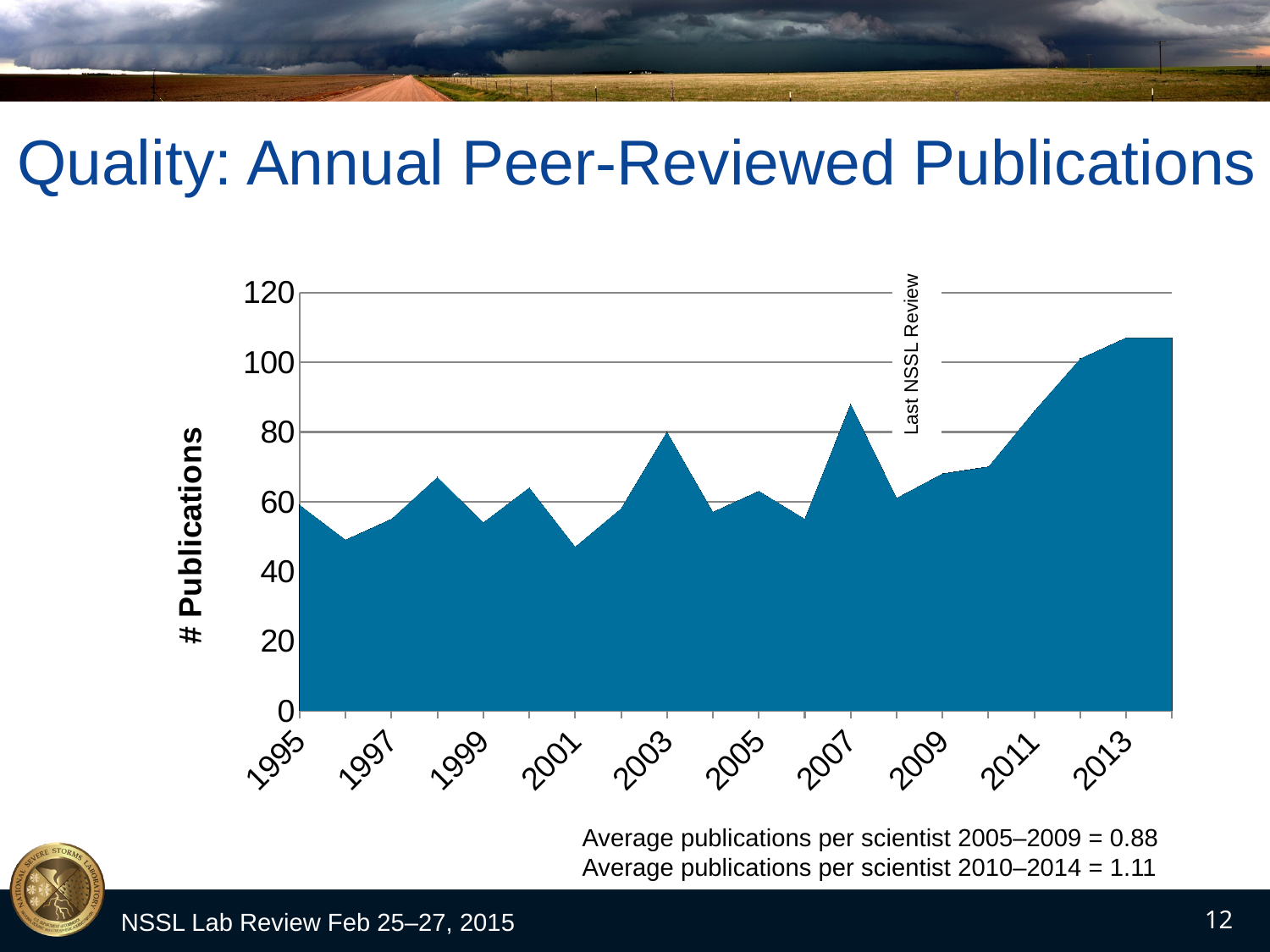
How many year labels are printed along the x axis? 10 Is the value for 2001 greater or less than 60? less What does the vertical annotation text inside the chart say? Last NSSL Review What is the label on the vertical axis of the chart? # Publications Is the value for 2003 greater or less than 60? greater Which year has the higher number of publications, 1995 or 2013? 2013 Is the value for 2007 greater or less than 80? greater Which year has the higher number of publications, 2003 or 2007? 2007 What kind of chart is shown on the slide? area chart Do the number of publications generally rise or fall from 2009 to 2013? rise